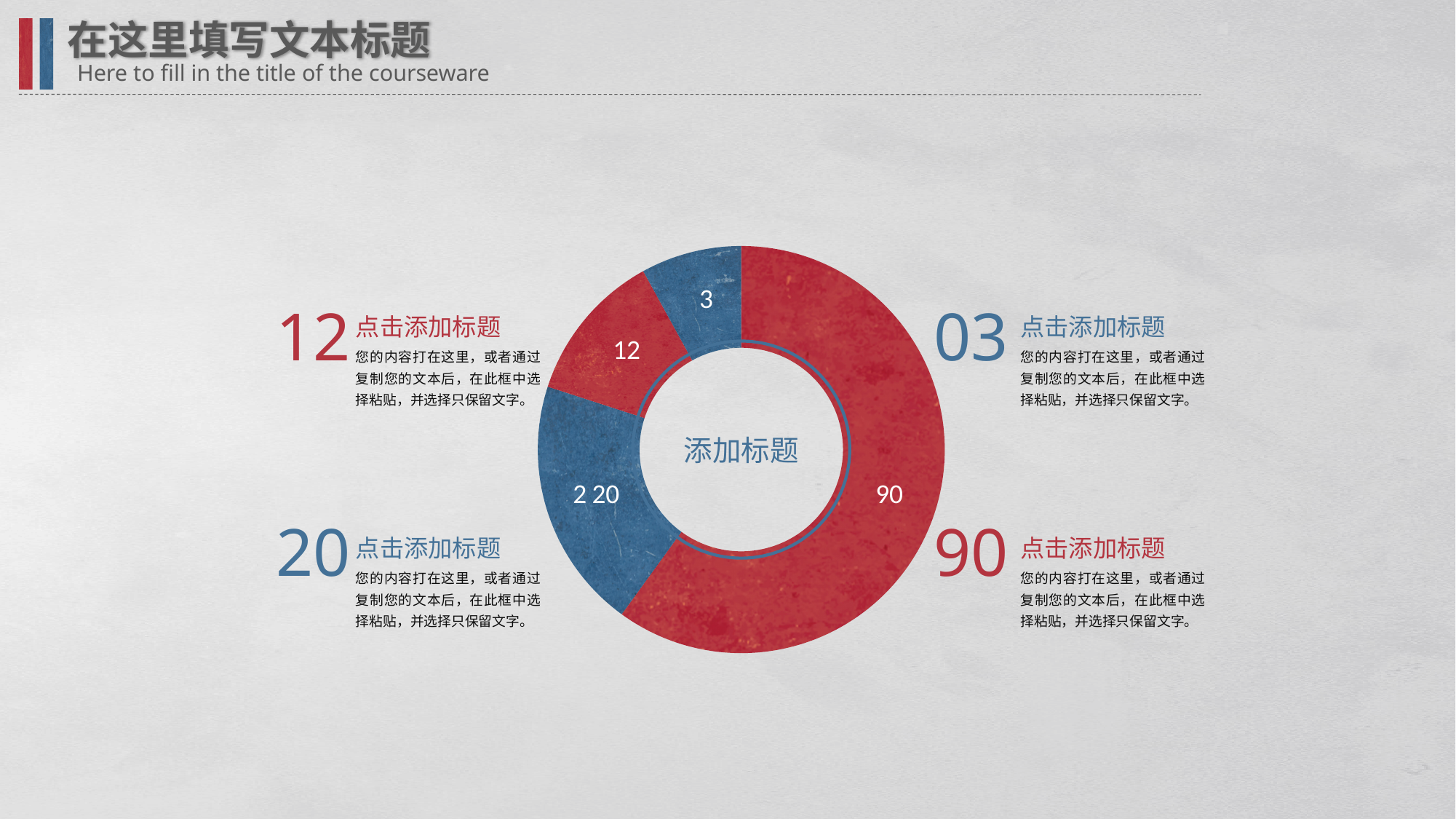
What is the sum of all four slice values in the donut chart? 125 What text is shown in the centre of the donut chart? 添加标题 What value is printed on the large red slice on the right side of the donut chart? 90 How many slices does the donut chart have? 4 What is the value of the largest slice in the donut chart? 90 What value is printed on the small blue slice at the top of the donut chart? 3 What is the value of the smallest slice in the donut chart? 3 What kind of chart is shown on the slide? donut chart What is the difference between the slice labelled 12 and the slice labelled 3? 9 Which is larger: the red slice labelled 12 or the blue slice labelled 3? 12 What is the difference between the slice labelled 90 and the slice labelled 12? 78 What two colours are used for the slices of the donut chart? red and blue